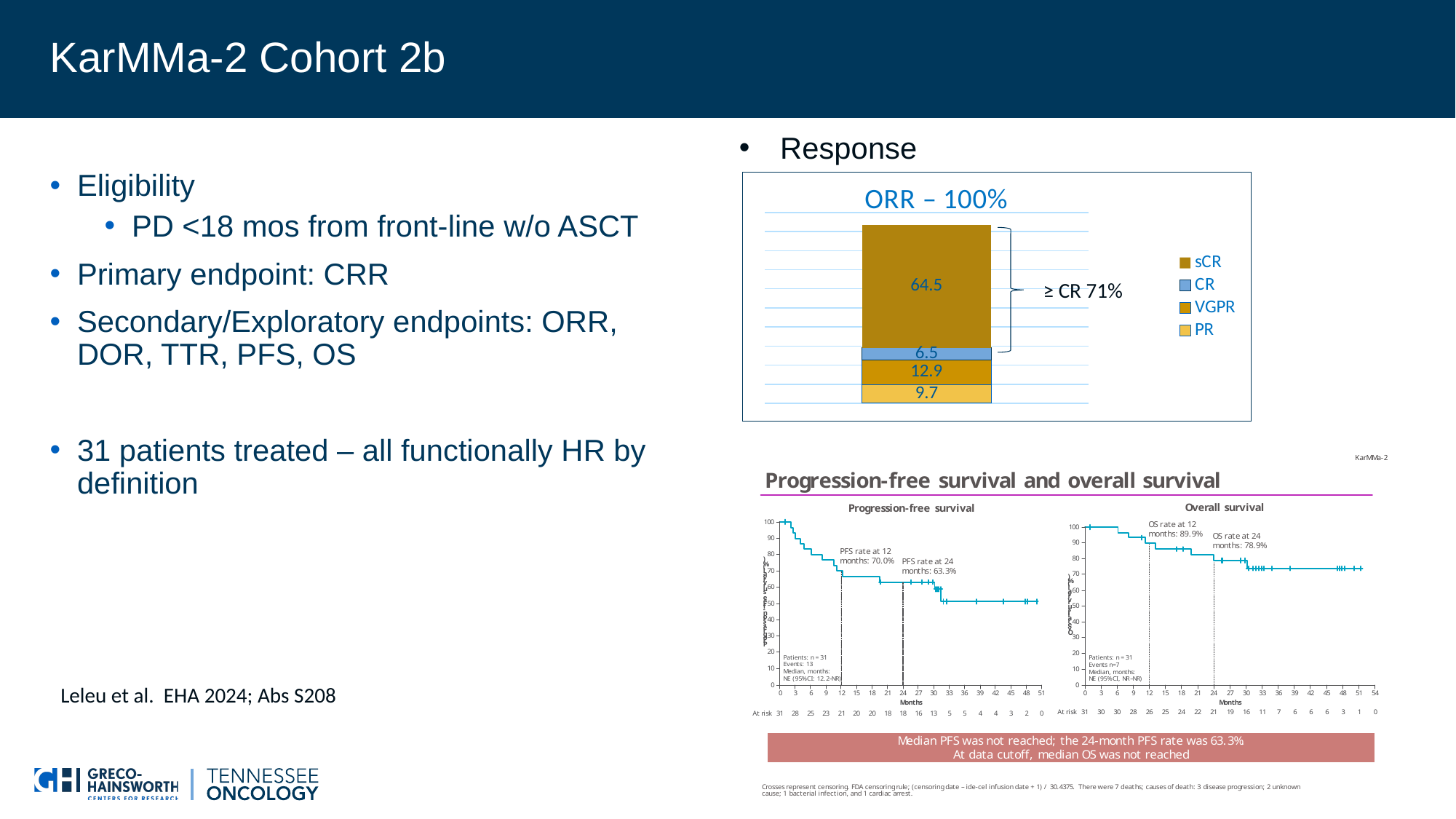
In the ORR – 100% chart, what is the value of the PR segment? 9.7 What kind of chart is the ORR – 100% chart? Stacked bar chart In the Overall survival chart, what is the OS rate at 12 months? 89.9% In the ORR – 100% chart, what is the combined value of the sCR and CR segments? 71 How many entries does the legend of the ORR – 100% chart list? 4 In the ORR – 100% chart, what is the difference between the sCR and VGPR values? 51.6 In the ORR – 100% chart, which response category has the largest segment? sCR In the ORR – 100% chart, what is the value of the VGPR segment? 12.9 In the Progression-free survival chart, what is the PFS rate at 24 months? 63.3% In the ORR – 100% chart, which is larger, the VGPR segment or the PR segment? VGPR In the ORR – 100% chart, which response category has the smallest segment? CR In the ORR – 100% chart, what is the value of the sCR segment? 64.5